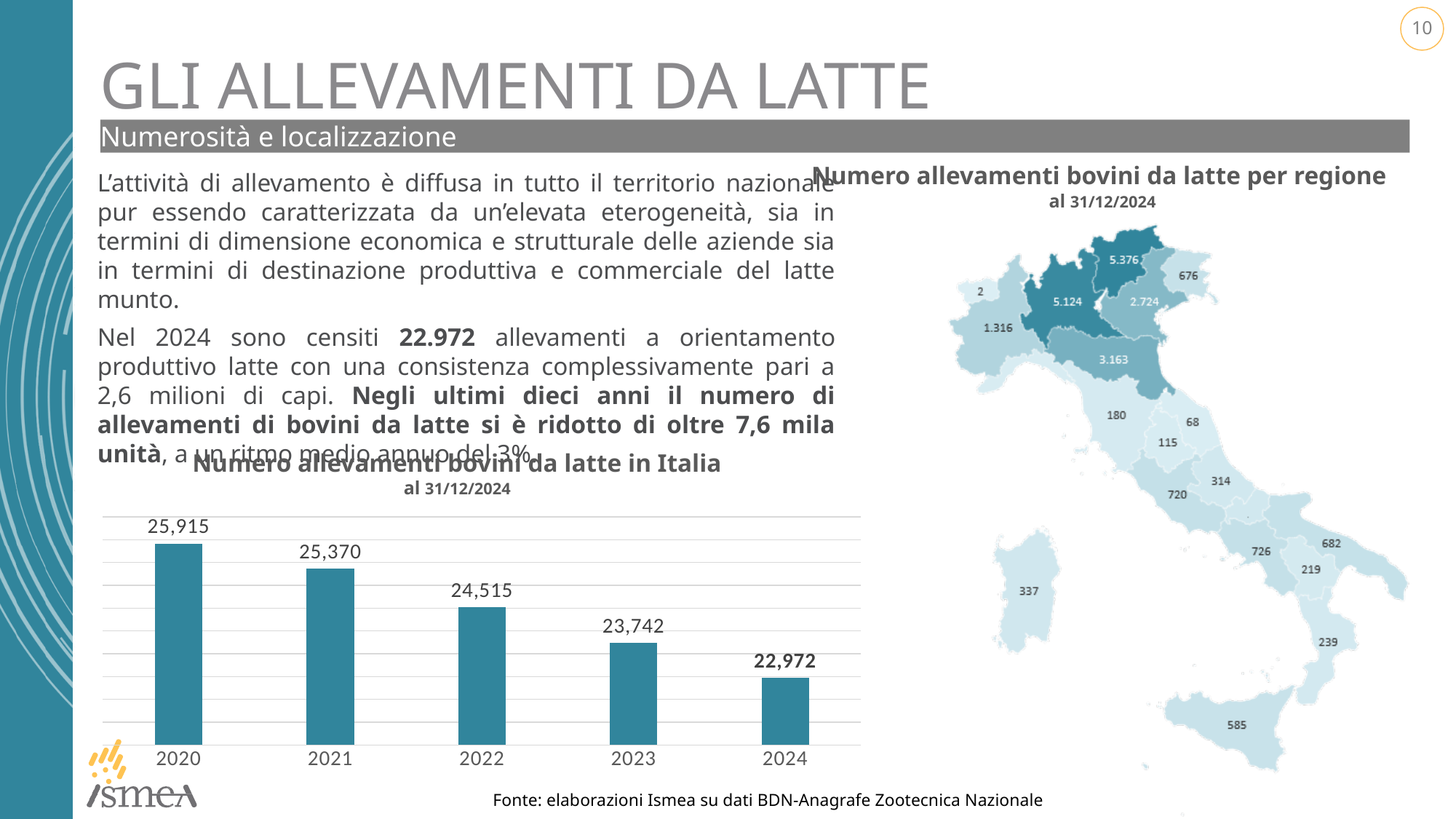
In the bar chart 'Numero allevamenti bovini da latte in Italia', which year has the lowest value? 2024 In the bar chart 'Numero allevamenti bovini da latte in Italia', what is the difference between the 2021 and 2022 values? 855 In the bar chart 'Numero allevamenti bovini da latte in Italia', what is the value for 2022? 24,515 In the bar chart 'Numero allevamenti bovini da latte in Italia', which year has the highest value? 2020 How many years are shown in the bar chart 'Numero allevamenti bovini da latte in Italia'? 5 In the bar chart 'Numero allevamenti bovini da latte in Italia', what is the value for 2024? 22,972 What is the title of the map chart on the right side of the slide? Numero allevamenti bovini da latte per regione In the bar chart 'Numero allevamenti bovini da latte in Italia', what is the difference between the 2020 and 2024 values? 2,943 In the bar chart 'Numero allevamenti bovini da latte in Italia', what is the value for 2020? 25,915 What kind of chart is 'Numero allevamenti bovini da latte in Italia'? bar chart In the bar chart 'Numero allevamenti bovini da latte in Italia', do the values rise or fall from 2020 to 2024? fall In the bar chart 'Numero allevamenti bovini da latte in Italia', which is larger, the value for 2021 or the value for 2023? 2021